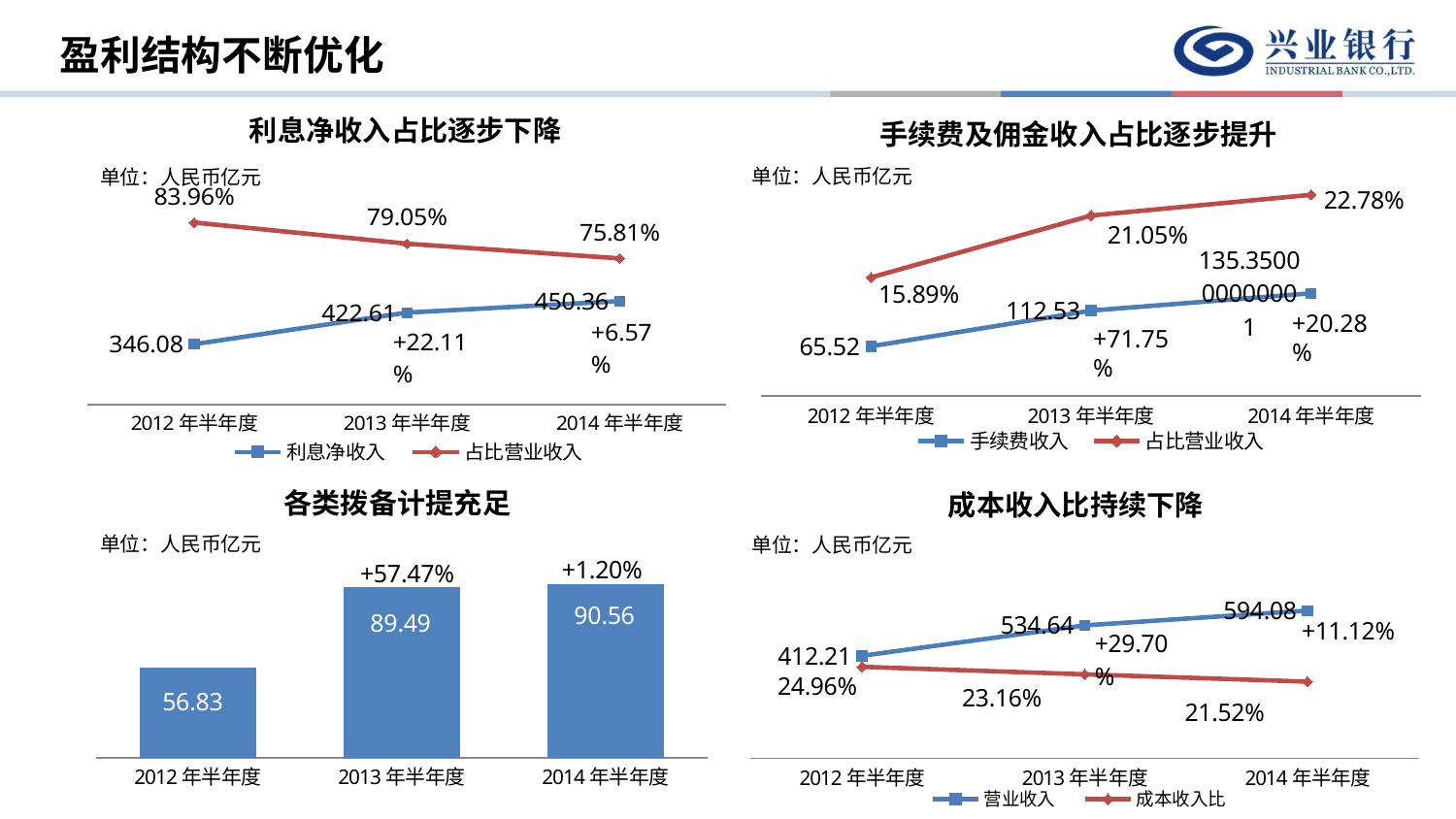
In the chart titled 利息净收入占比逐步下降, what is the difference between the 利息净收入 values for 2013 年半年度 and 2012 年半年度? 76.53 In the chart titled 成本收入比持续下降, which is larger, the 成本收入比 for 2012 年半年度 or for 2014 年半年度? 2012 年半年度 In the chart titled 利息净收入占比逐步下降, what is the 占比营业收入 value for 2014 年半年度? 75.81% In the chart titled 成本收入比持续下降, what is the 营业收入 value for 2014 年半年度? 594.08 In the chart titled 各类拨备计提充足, which period has the highest value? 2014 年半年度 In the chart titled 手续费及佣金收入占比逐步提升, what is the 占比营业收入 value for 2013 年半年度? 21.05% In the chart titled 手续费及佣金收入占比逐步提升, how many series does the legend list? 2 In the chart titled 各类拨备计提充足, what is the value for 2013 年半年度? 89.49 In the chart titled 手续费及佣金收入占比逐步提升, which period has the lowest 手续费收入? 2012 年半年度 In the chart titled 利息净收入占比逐步下降, does the 占比营业收入 line rise or fall from 2012 年半年度 to 2014 年半年度? fall In the chart titled 利息净收入占比逐步下降, what is the value of 利息净收入 for 2012 年半年度? 346.08 What kind of chart is the one titled 各类拨备计提充足? bar chart